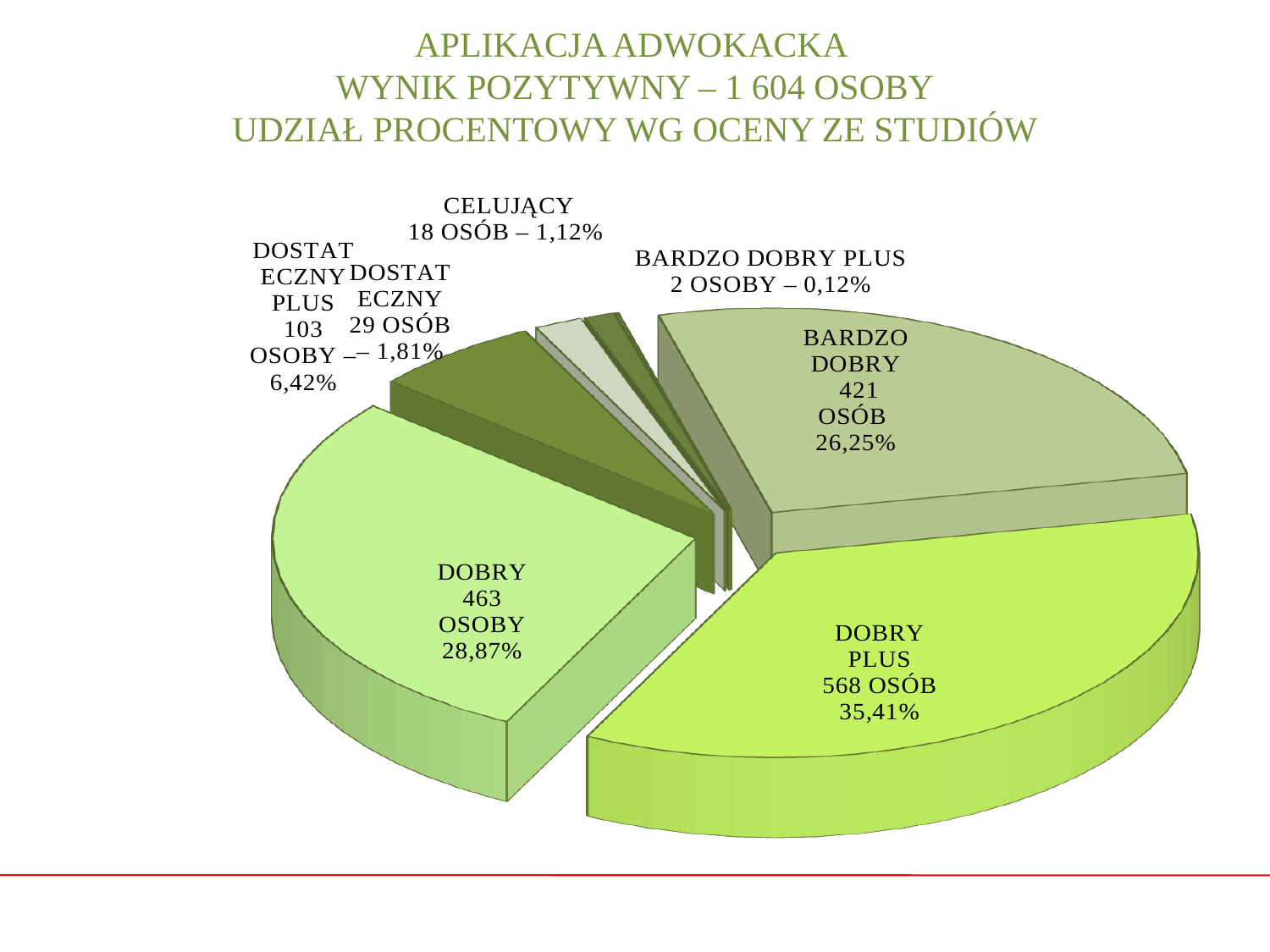
According to the chart title, how many people achieved a positive result (WYNIK POZYTYWNY)? 1 604 What percentage share does the DOSTATECZNY PLUS slice have? 6,42% How many people are in the BARDZO DOBRY category? 421 What percentage share does the DOBRY PLUS slice have? 35,41% What kind of chart is shown on the slide? pie chart What is the difference in percentage share between DOSTATECZNY PLUS and DOSTATECZNY? 4,61% Which category has the smallest share of the pie? BARDZO DOBRY PLUS How many categories (grades) does the pie chart show? 7 Which category has the largest share of the pie? DOBRY PLUS What is the difference in the number of people between DOBRY PLUS and DOBRY? 105 How many people are in the CELUJĄCY category? 18 Which category has more people, DOBRY or BARDZO DOBRY? DOBRY